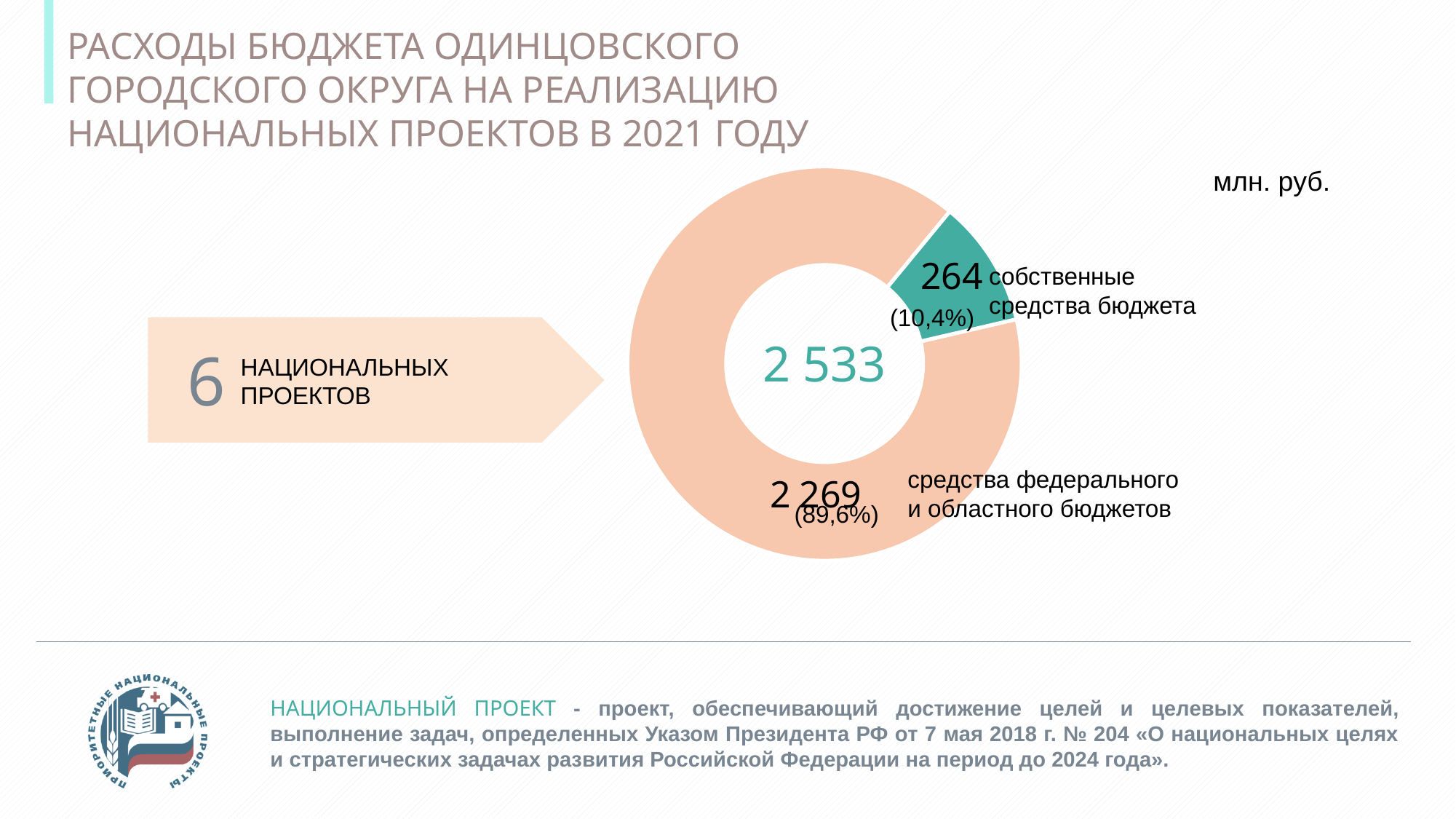
How many segments does the donut chart have? 2 What is the value for средства федерального и областного бюджетов? 2 269 What share of the chart does средства федерального и областного бюджетов represent? 89,6% Which segment of the chart is the smallest? собственные средства бюджета In what units are the chart values given? млн. руб. What is the value for собственные средства бюджета? 264 What is the difference between средства федерального и областного бюджетов and собственные средства бюджета? 2 005 What share of the chart does собственные средства бюджета represent? 10,4% What kind of chart is shown on the slide? Donut (pie) chart Which is larger: собственные средства бюджета or средства федерального и областного бюджетов? средства федерального и областного бюджетов Which segment of the chart is the largest? средства федерального и областного бюджетов What total value is shown in the centre of the donut chart? 2 533